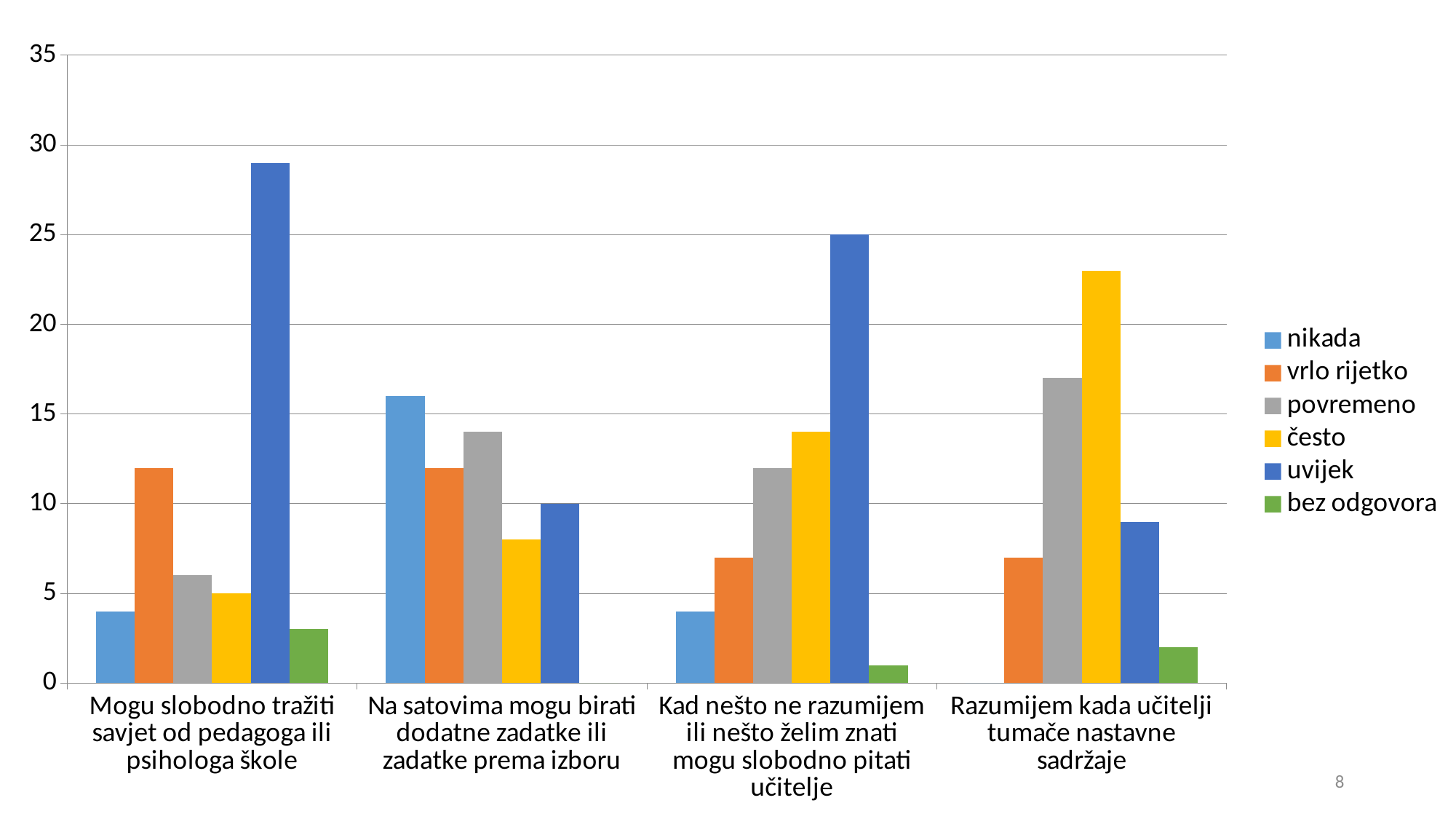
Which is larger for "Na satovima mogu birati dodatne zadatke ili zadatke prema izboru": "povremeno" or "često"? povremeno Is the value of "često" for "Razumijem kada učitelji tumače nastavne sadržaje" greater or less than 20? greater How many series does the legend list? 6 Is the value of "uvijek" for "Mogu slobodno tražiti savjet od pedagoga ili psihologa škole" greater or less than 25? greater Which series has the highest value for "Mogu slobodno tražiti savjet od pedagoga ili psihologa škole"? uvijek How many categories are shown on the x axis? 4 Is the value of "nikada" for "Kad nešto ne razumijem ili nešto želim znati mogu slobodno pitati učitelje" greater or less than 5? less Which series has the highest value for "Na satovima mogu birati dodatne zadatke ili zadatke prema izboru"? nikada Which series has the highest value for "Razumijem kada učitelji tumače nastavne sadržaje"? često What kind of chart is shown on the slide? bar chart Which is larger for "Kad nešto ne razumijem ili nešto želim znati mogu slobodno pitati učitelje": "uvijek" or "često"? uvijek What colour are the bars for the "često" series? yellow